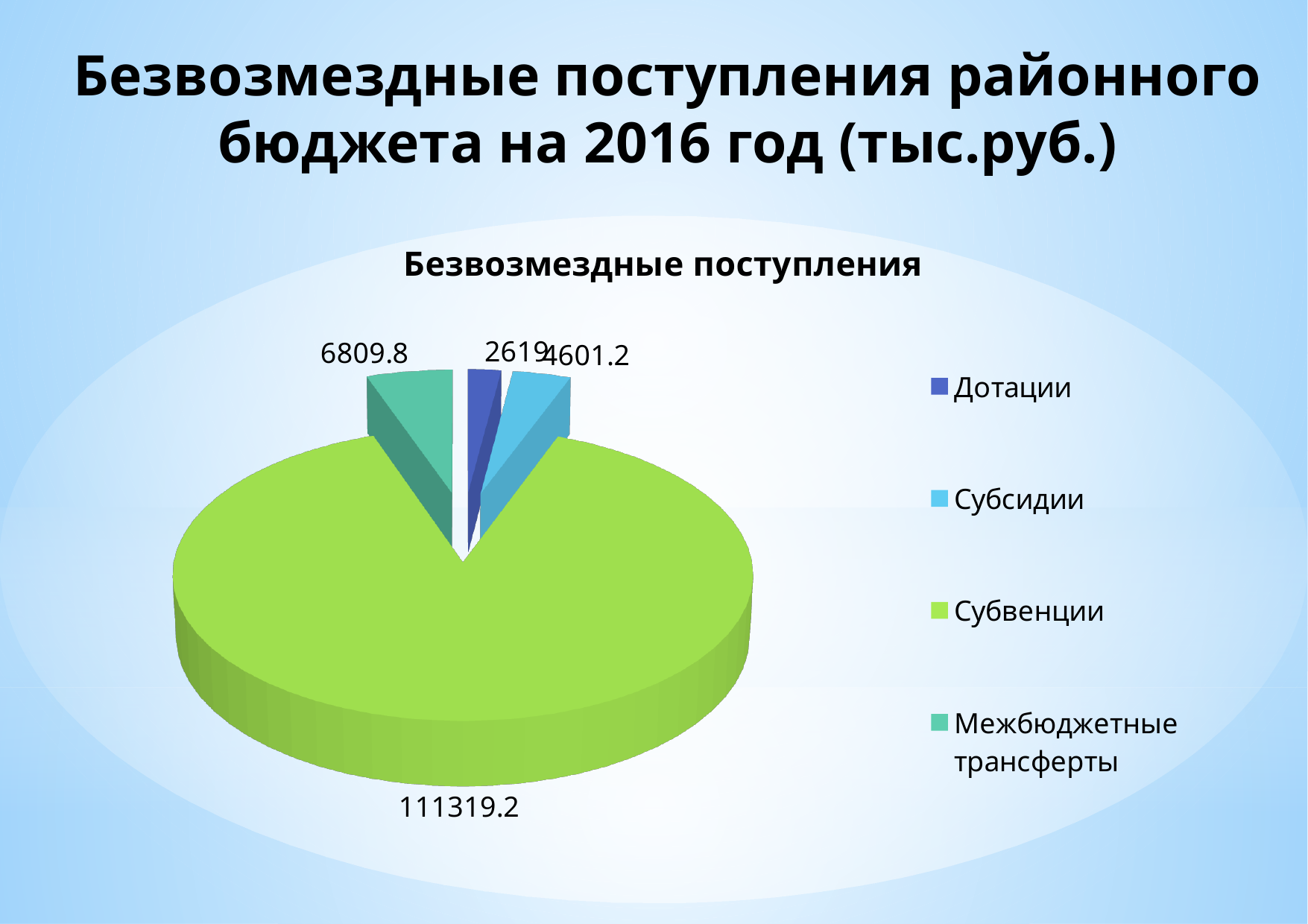
What is the title of the chart? Безвозмездные поступления What is the value for Субсидии? 4601.2 How many categories does the pie chart show? 4 Which is larger, Межбюджетные трансферты or Субсидии? Межбюджетные трансферты What is the value for Межбюджетные трансферты? 6809.8 Which category has the smallest slice of the pie? Дотации What kind of chart is shown on the slide? pie chart What is the value for Субвенции? 111319.2 Which is larger, Субсидии or Дотации? Субсидии What is the difference between the values for Межбюджетные трансферты and Субсидии? 2208.6 Which category has the largest slice of the pie? Субвенции What is the difference between the values for Субвенции and Межбюджетные трансферты? 104509.4